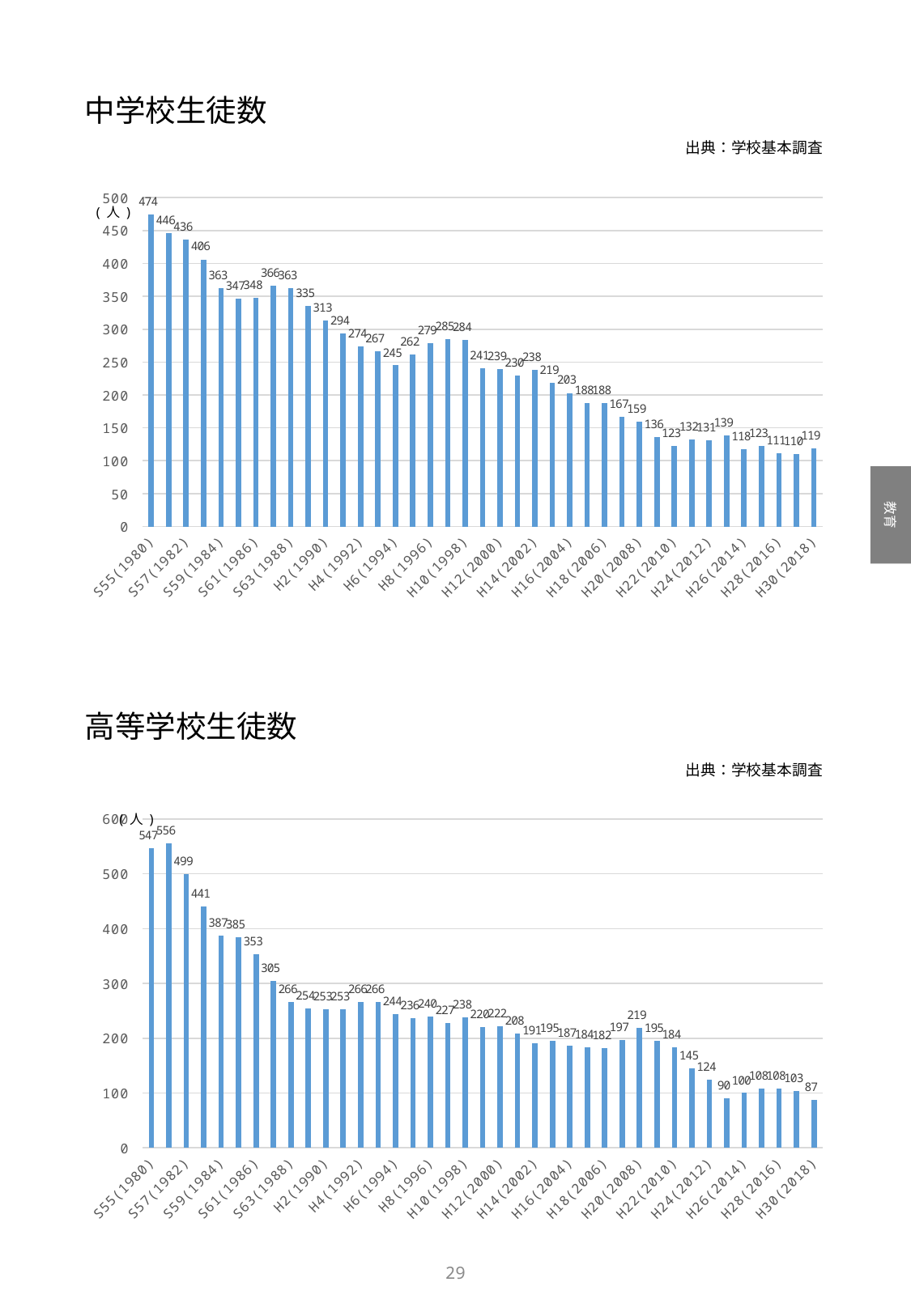
In the 中学校生徒数 chart, which is larger, the value for H8(1996) or the value for H6(1994)? H8(1996) In the 中学校生徒数 chart, what is the value for H30(2018)? 119 In the 中学校生徒数 chart, which year has the highest value? S55(1980) In the 高等学校生徒数 chart, what is the difference between the values for S59(1984) and S61(1986)? 34 In the 高等学校生徒数 chart, what is the value for S55(1980)? 547 In the 中学校生徒数 chart, what is the difference between the values for S55(1980) and H30(2018)? 355 What source is cited for the 中学校生徒数 chart? 学校基本調査 In the 高等学校生徒数 chart, which year has the lowest value? H30(2018) In the 中学校生徒数 chart, what is the value for S55(1980)? 474 What kind of chart is the 高等学校生徒数 chart? bar chart In the 高等学校生徒数 chart, what is the value for H20(2008)? 219 In the 中学校生徒数 chart, do the values generally rise or fall from left to right? fall